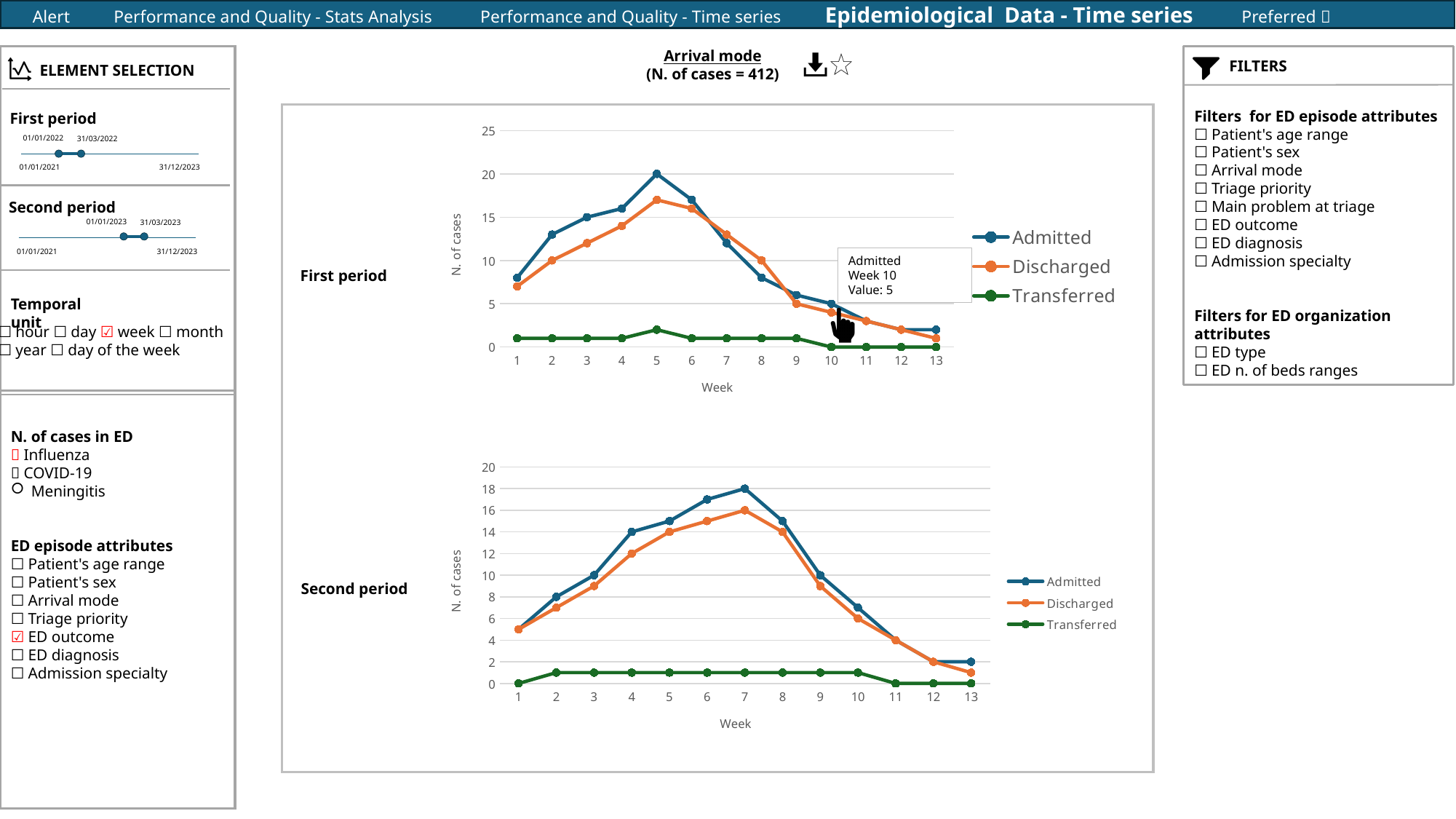
How many series does the legend of the Second period chart list? 3 On the Second period chart, which is larger in week 7: Admitted or Discharged? Admitted On the First period chart, in which week does the Admitted series reach its highest value? Week 5 On the First period chart, what is the value for Admitted in week 5? 20 On the First period chart, is the value for Discharged in week 5 greater or less than 15? greater What is the number of cases stated in the chart title? 412 On the Second period chart, how many weeks are shown on the x axis? 13 On the First period chart, which series is lowest across all weeks? Transferred On the First period chart, what is the value for Admitted in week 10? 5 On the Second period chart, do the Admitted values rise or fall from week 7 to week 13? Fall On the Second period chart, what is the value for Admitted in week 7? 18 What kind of chart is the Second period chart? Line chart